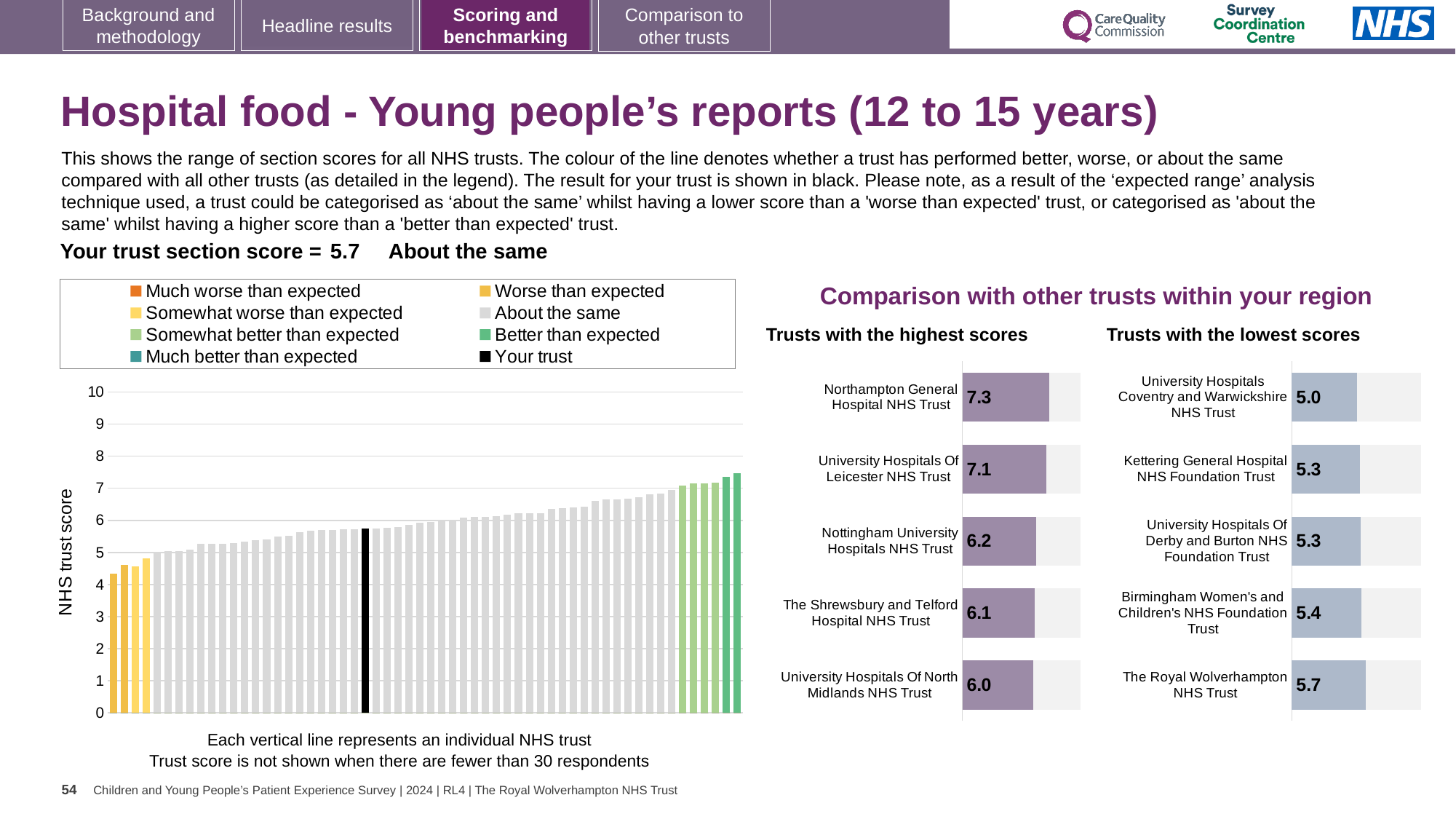
In the large chart on the left, do the trust scores rise or fall from left to right? Rise In the 'Trusts with the highest scores' chart, which has a higher score: University Hospitals Of Leicester NHS Trust or Nottingham University Hospitals NHS Trust? University Hospitals Of Leicester NHS Trust In the 'Trusts with the lowest scores' chart, what is the score for Kettering General Hospital NHS Foundation Trust? 5.3 In the 'Trusts with the highest scores' chart, which trust has the highest score? Northampton General Hospital NHS Trust In the 'Trusts with the highest scores' chart, what is the difference between the scores of Northampton General Hospital NHS Trust and University Hospitals Of North Midlands NHS Trust? 1.3 In the large chart on the left, is the value of the tallest bar greater or less than 7? greater In the 'Trusts with the lowest scores' chart, what is the difference between the scores of The Royal Wolverhampton NHS Trust and University Hospitals Coventry and Warwickshire NHS Trust? 0.7 How many trusts are listed in the 'Trusts with the lowest scores' chart? 5 In the 'Trusts with the highest scores' chart, what is the score for Northampton General Hospital NHS Trust? 7.3 What kind of chart is the large chart on the left showing NHS trust scores? Bar chart How many entries does the legend of the large chart on the left list? 8 In the 'Trusts with the lowest scores' chart, which trust has the lowest score? University Hospitals Coventry and Warwickshire NHS Trust